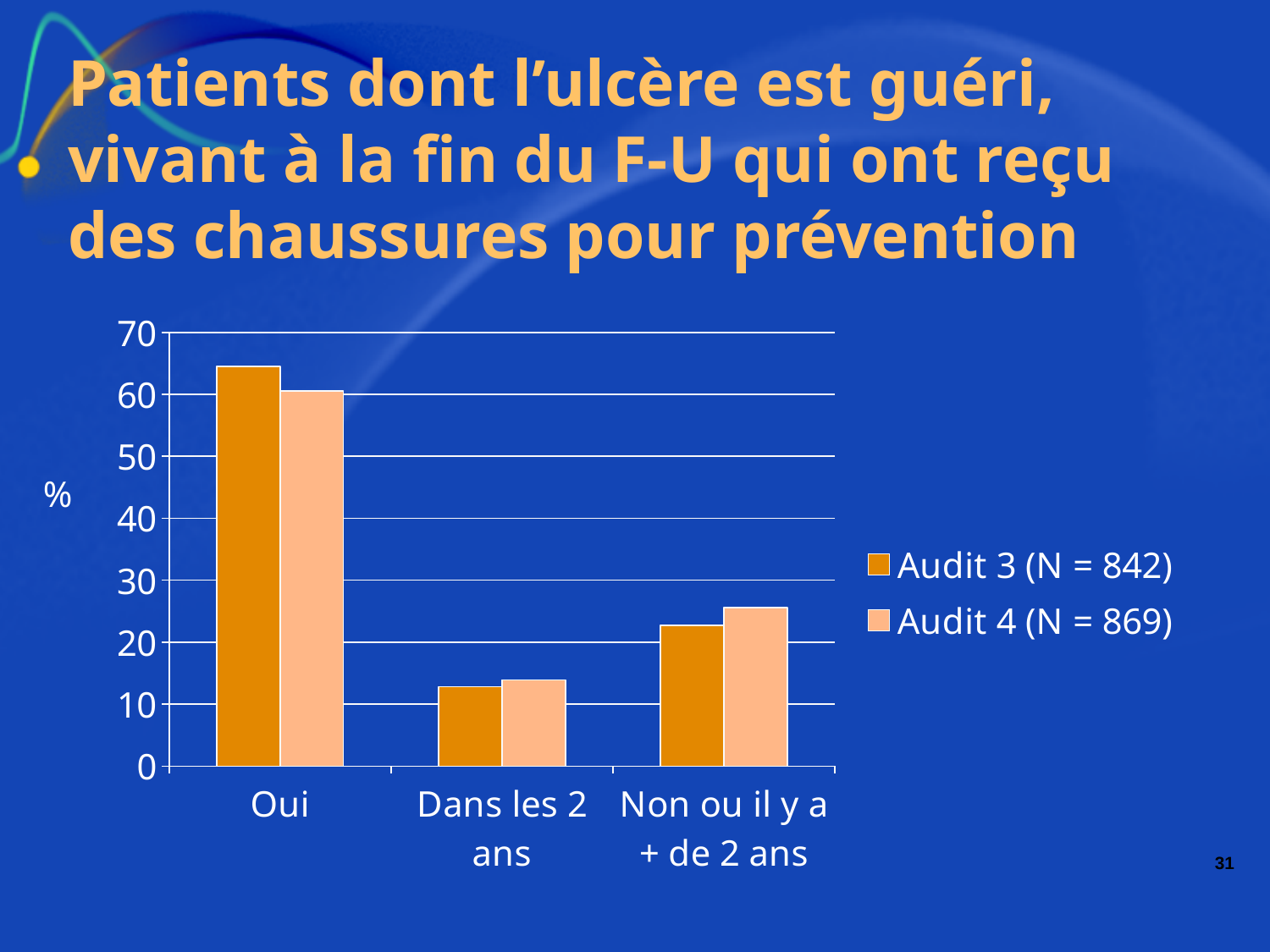
Is the value for Non ou il y a + de 2 ans in Audit 4 (N = 869) greater or less than 30? less Which category has the highest value for Audit 3 (N = 842)? Oui For the category Oui, which series has the larger value, Audit 3 (N = 842) or Audit 4 (N = 869)? Audit 3 (N = 842) Is the value for Oui in Audit 4 (N = 869) greater or less than 50? greater What label is shown on the y axis of the chart? % How many series does the legend list? 2 Which category has the lowest value for Audit 4 (N = 869)? Dans les 2 ans Is the value for Dans les 2 ans in Audit 3 (N = 842) greater or less than 20? less How many categories are shown on the x axis? 3 What kind of chart is shown on the slide? bar chart For the category Non ou il y a + de 2 ans, which series has the larger value, Audit 3 (N = 842) or Audit 4 (N = 869)? Audit 4 (N = 869)